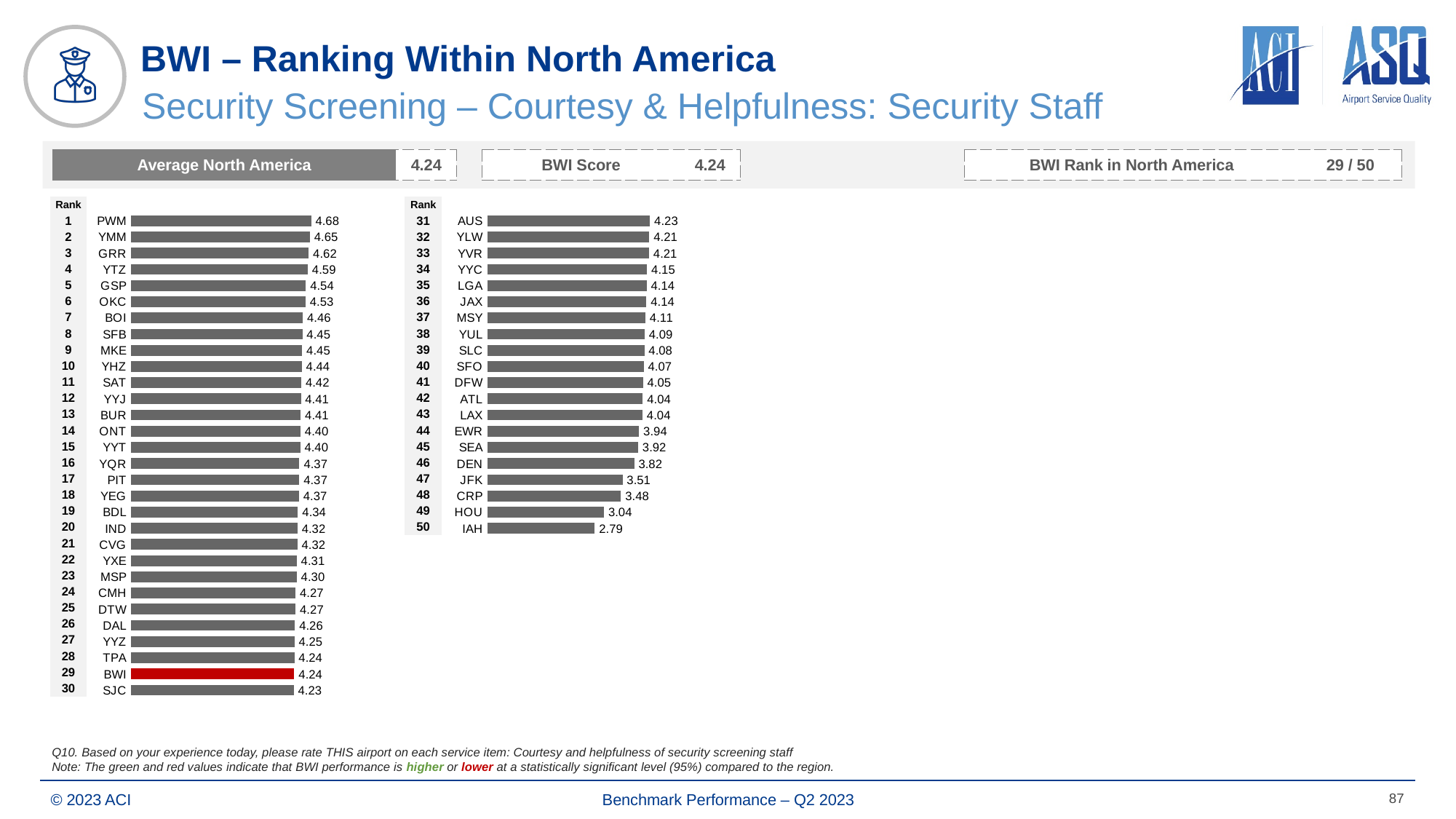
What is the score shown for SFO? 4.07 Do the scores rise or fall as the rank number increases? fall What is BWI's rank in North America according to the slide? 29 / 50 Which airport has the highest score in the ranking chart? PWM How many airports are ranked in the chart? 50 Which has a higher score, JFK or DEN? DEN Which airport has the lowest score in the ranking chart? IAH What kind of chart is used to show the airport rankings on this slide? bar chart What is the score shown for HOU? 3.04 What is the difference between the scores of PWM and IAH? 1.89 What is the score shown for BWI? 4.24 What colour is the bar for BWI? red